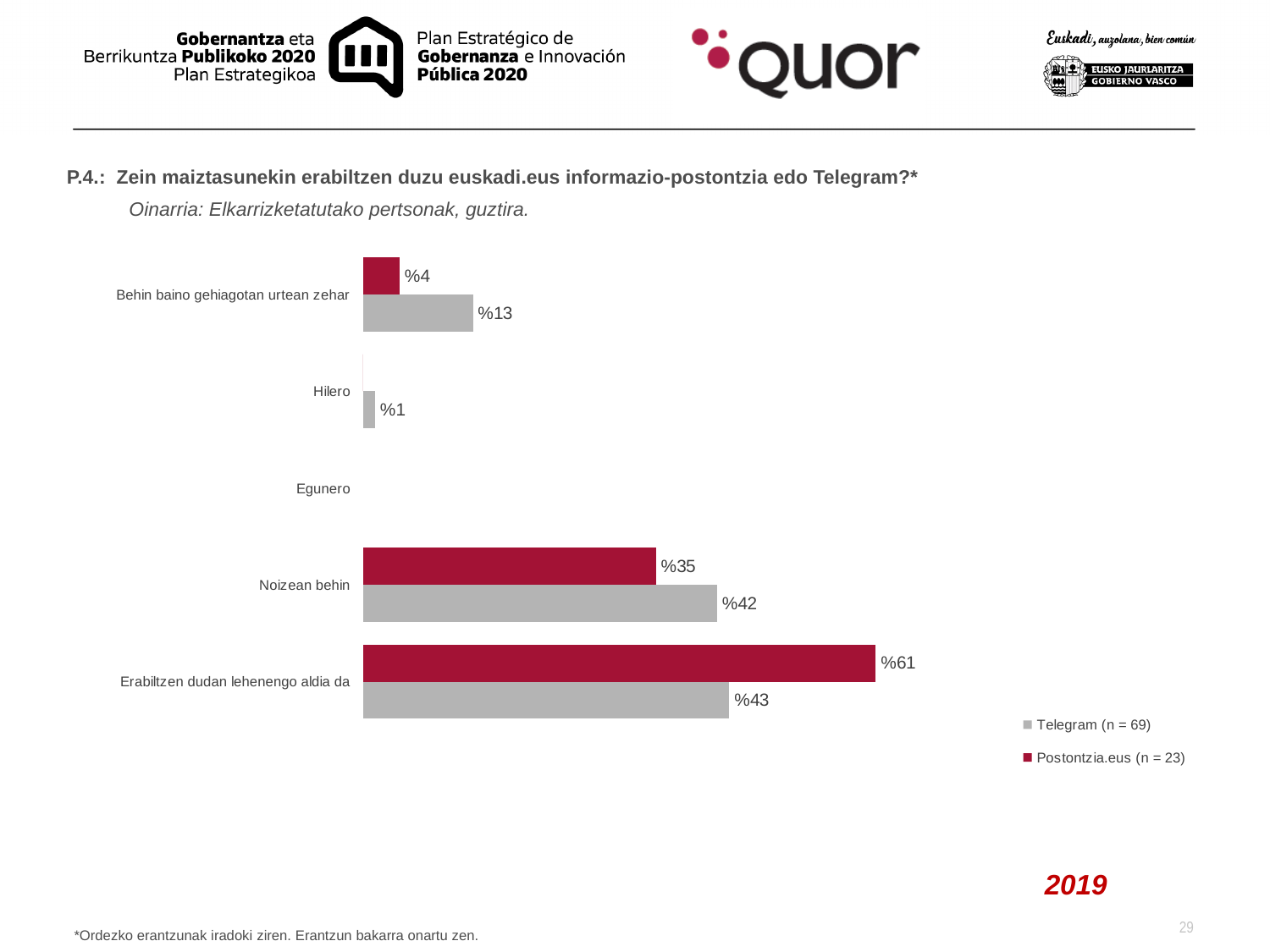
For "Noizean behin", which series has the larger value, Telegram or Postontzia.eus? Telegram What is the Telegram value for "Noizean behin"? %42 Which category has the highest Postontzia.eus value? Erabiltzen dudan lehenengo aldia da What is the Postontzia.eus value for "Behin baino gehiagotan urtean zehar"? %4 What is the Telegram value for "Erabiltzen dudan lehenengo aldia da"? %43 What kind of chart is shown on the slide? Bar chart What is the difference between the Postontzia.eus and Telegram values for "Erabiltzen dudan lehenengo aldia da"? %18 How many series does the legend list? 2 Which category has the highest Telegram value? Erabiltzen dudan lehenengo aldia da What is the Telegram value for "Hilero"? %1 How many categories are shown on the chart? 5 What is the Postontzia.eus value for "Erabiltzen dudan lehenengo aldia da"? %61